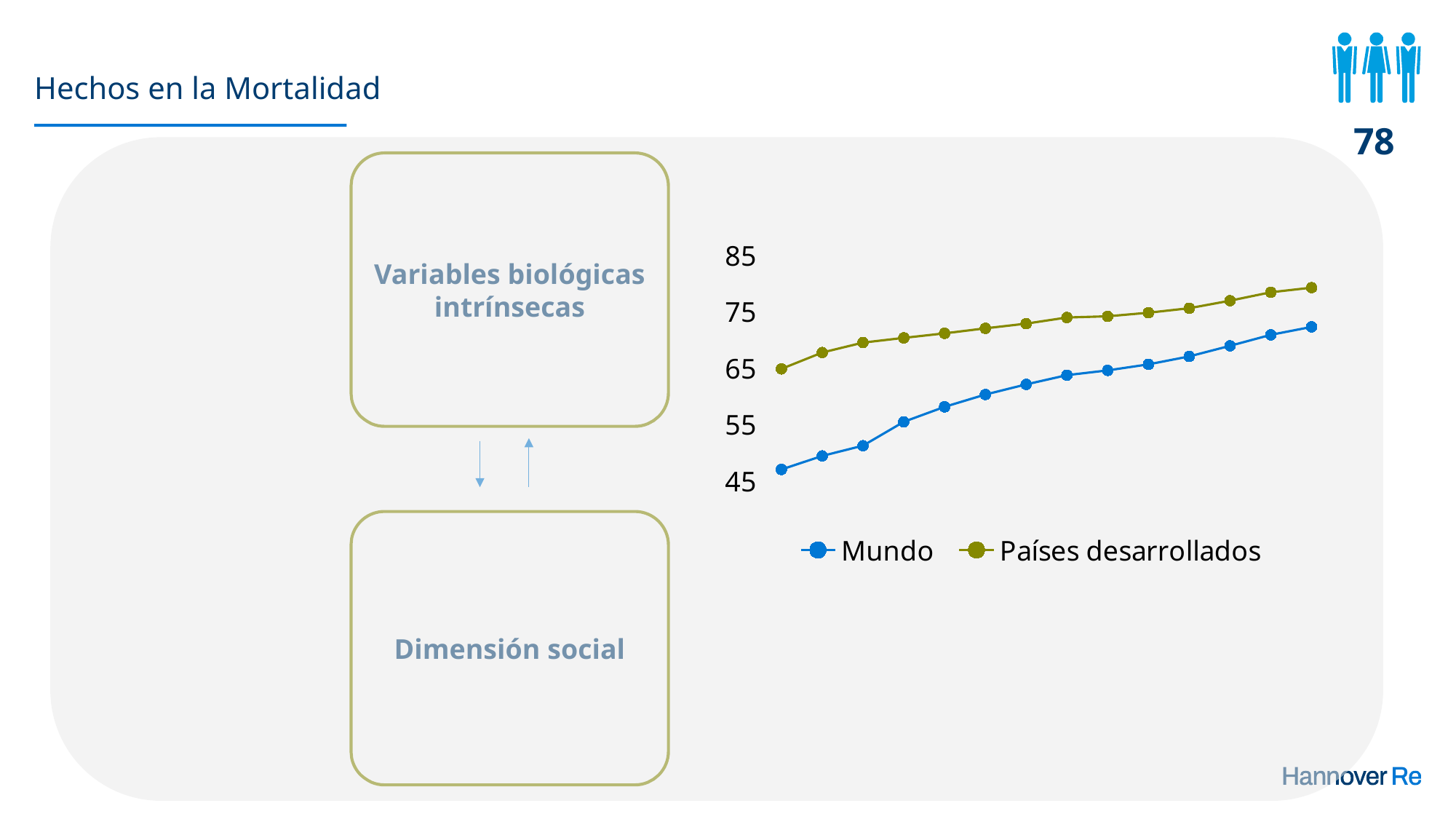
How many series does the chart legend list? 2 Do the values of the Mundo series rise or fall along the x axis? rise Which series has higher values throughout the chart, Mundo or Países desarrollados? Países desarrollados Is the last value of the Países desarrollados series greater or less than 75? greater Which colour is used for the Mundo series? blue What are the two series named in the chart legend? Mundo and Países desarrollados Is the first value of the Mundo series greater or less than 55? less Do the values of the Países desarrollados series rise or fall along the x axis? rise How many data points does each series in the chart have? 14 What kind of chart is shown on the slide? line chart Is the first value of the Países desarrollados series greater or less than 75? less